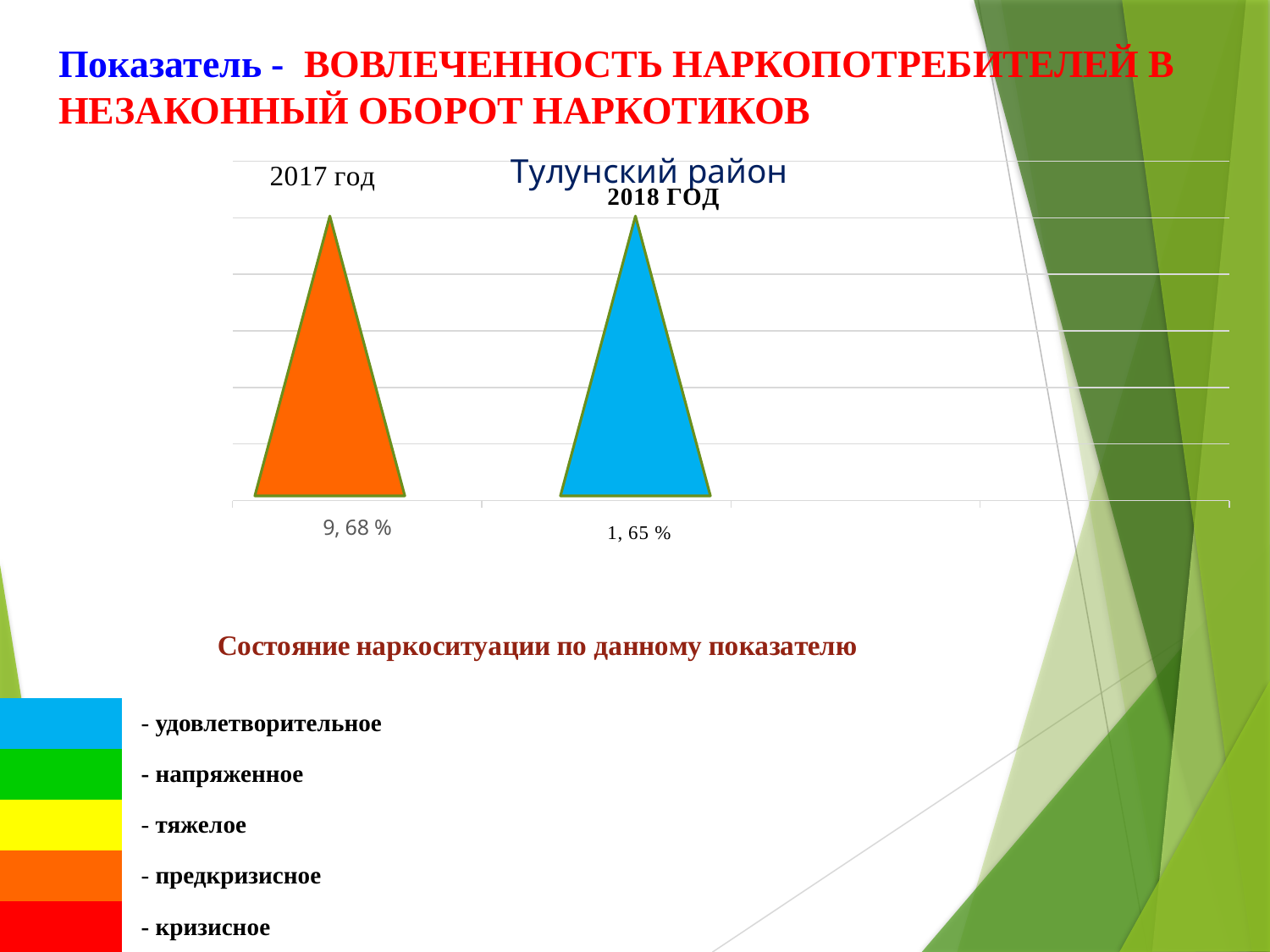
Which year has the lowest value? 2018 What is the title of the chart? Тулунский район According to the colour key at the bottom, which state does the blue colour of the 2018 shape correspond to? удовлетворительное Which year has the higher value, 2017 or 2018? 2017 How many years (categories) are shown in the chart? 2 Does the value rise or fall from 2017 to 2018? fall What is the value shown for 2018 год? 1, 65 % What colour is the shape for 2017 год? orange What is the value shown for 2017 год? 9, 68 % Which year has the highest value? 2017